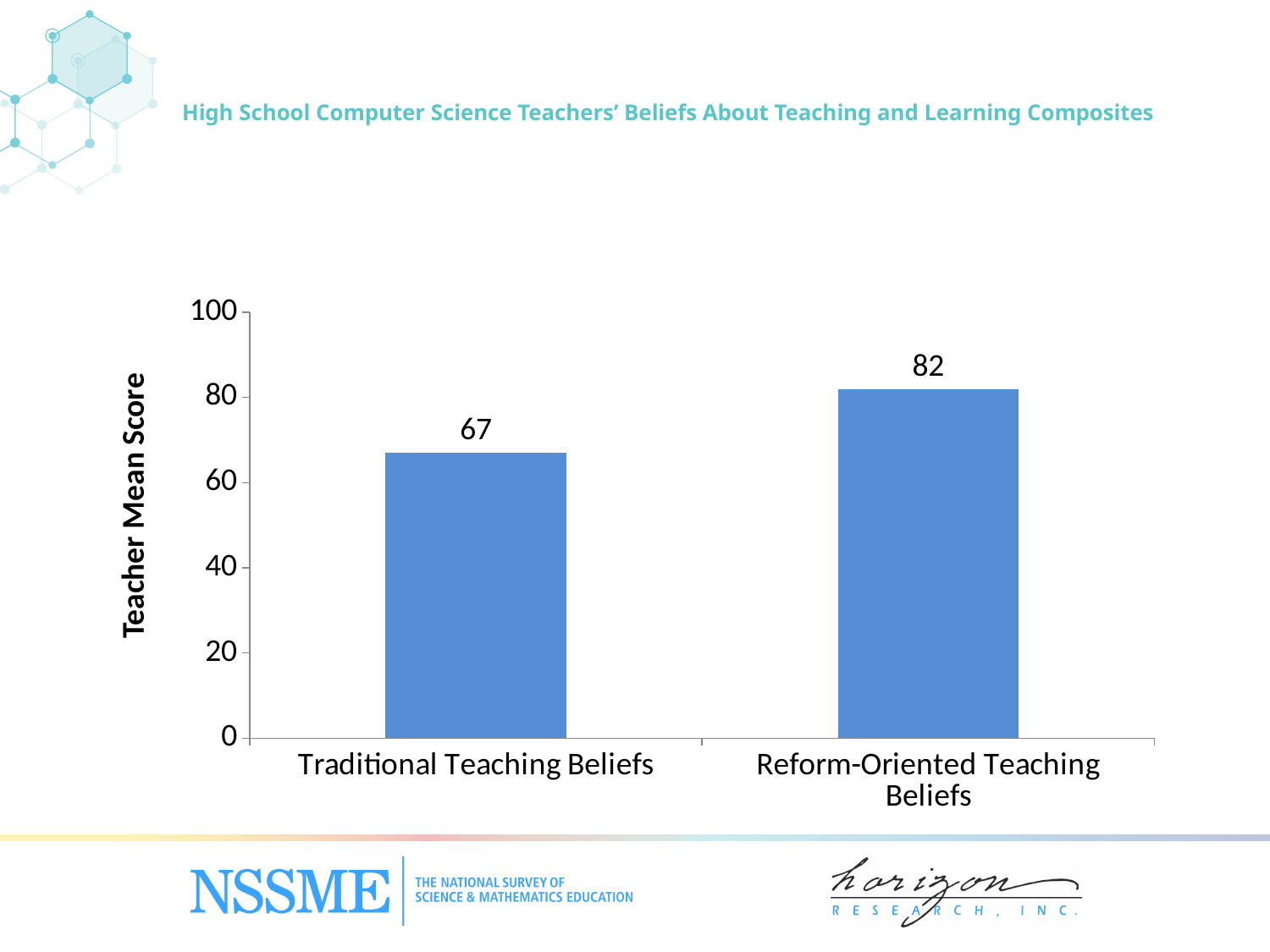
Is the teacher mean score for Traditional Teaching Beliefs larger or smaller than that for Reform-Oriented Teaching Beliefs? smaller What is the teacher mean score for Reform-Oriented Teaching Beliefs? 82 Which category has the higher teacher mean score? Reform-Oriented Teaching Beliefs Is the value for Reform-Oriented Teaching Beliefs greater or less than 80? greater Which category has the lower teacher mean score? Traditional Teaching Beliefs What is the title of the slide? High School Computer Science Teachers' Beliefs About Teaching and Learning Composites What is the difference between the teacher mean scores for Reform-Oriented Teaching Beliefs and Traditional Teaching Beliefs? 15 How many categories are shown on the x axis? 2 Is the value for Traditional Teaching Beliefs greater or less than 60? greater What is the teacher mean score for Traditional Teaching Beliefs? 67 What kind of chart is shown on the slide? bar chart What is the label of the vertical axis? Teacher Mean Score